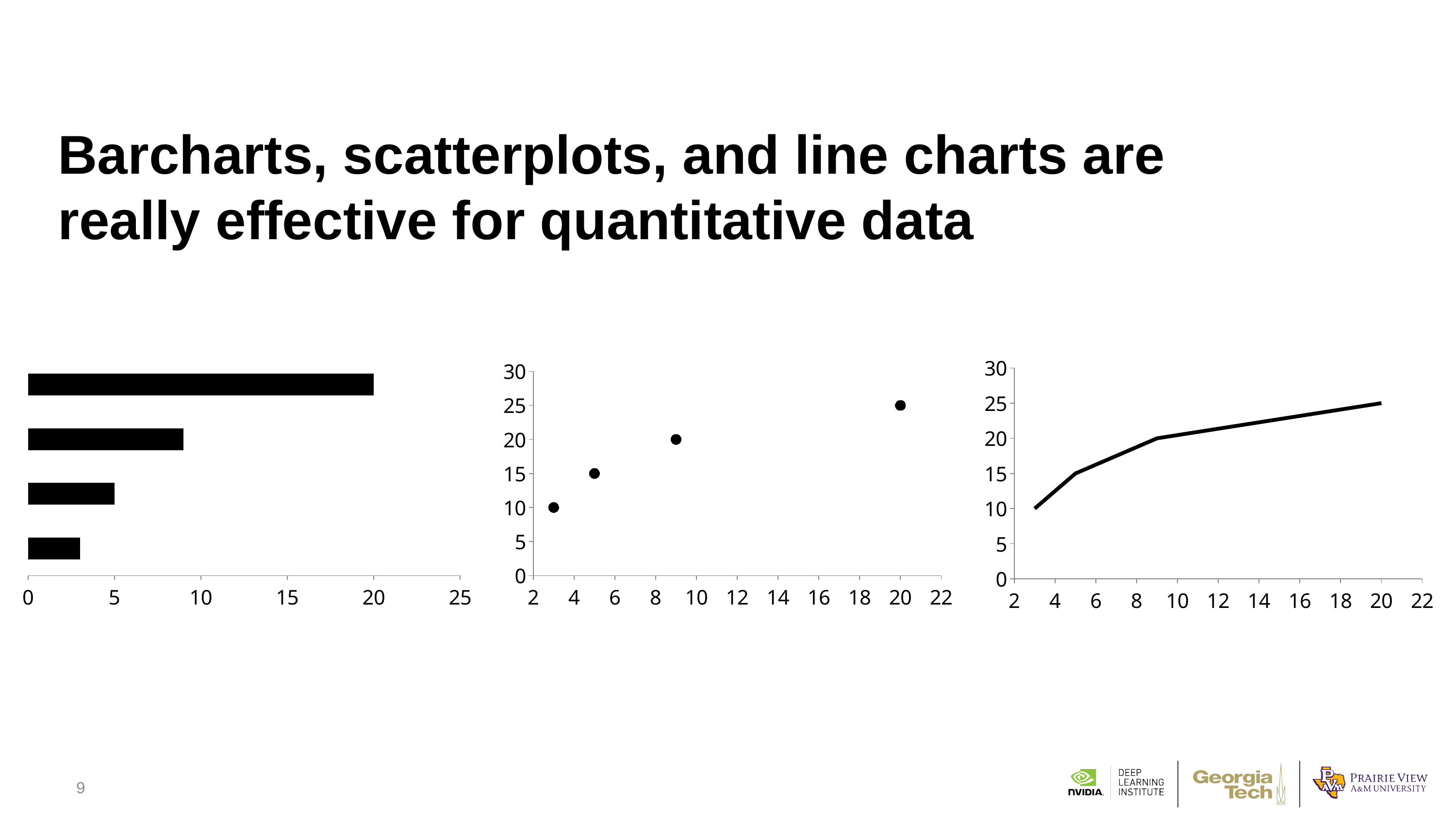
In the leftmost bar chart, what is the value of the third bar from the top? 5 In the leftmost bar chart, is the value of the bottom bar greater or less than 5? less In the rightmost line chart, do the values rise or fall as x increases? rise What kind of chart is the leftmost chart on the slide? bar chart What kind of chart is the middle chart on the slide? scatter plot In the leftmost bar chart, is the value of the second bar from the top greater or less than 5? greater In the leftmost bar chart, which bar is the longest? the top bar What kind of chart is the rightmost chart on the slide? line chart In the middle scatter plot, how many points are plotted? 4 In the leftmost bar chart, how many bars are plotted? 4 In the leftmost bar chart, what is the value of the top bar? 20 In the middle scatter plot, what is the y value of the point at x = 20? 25